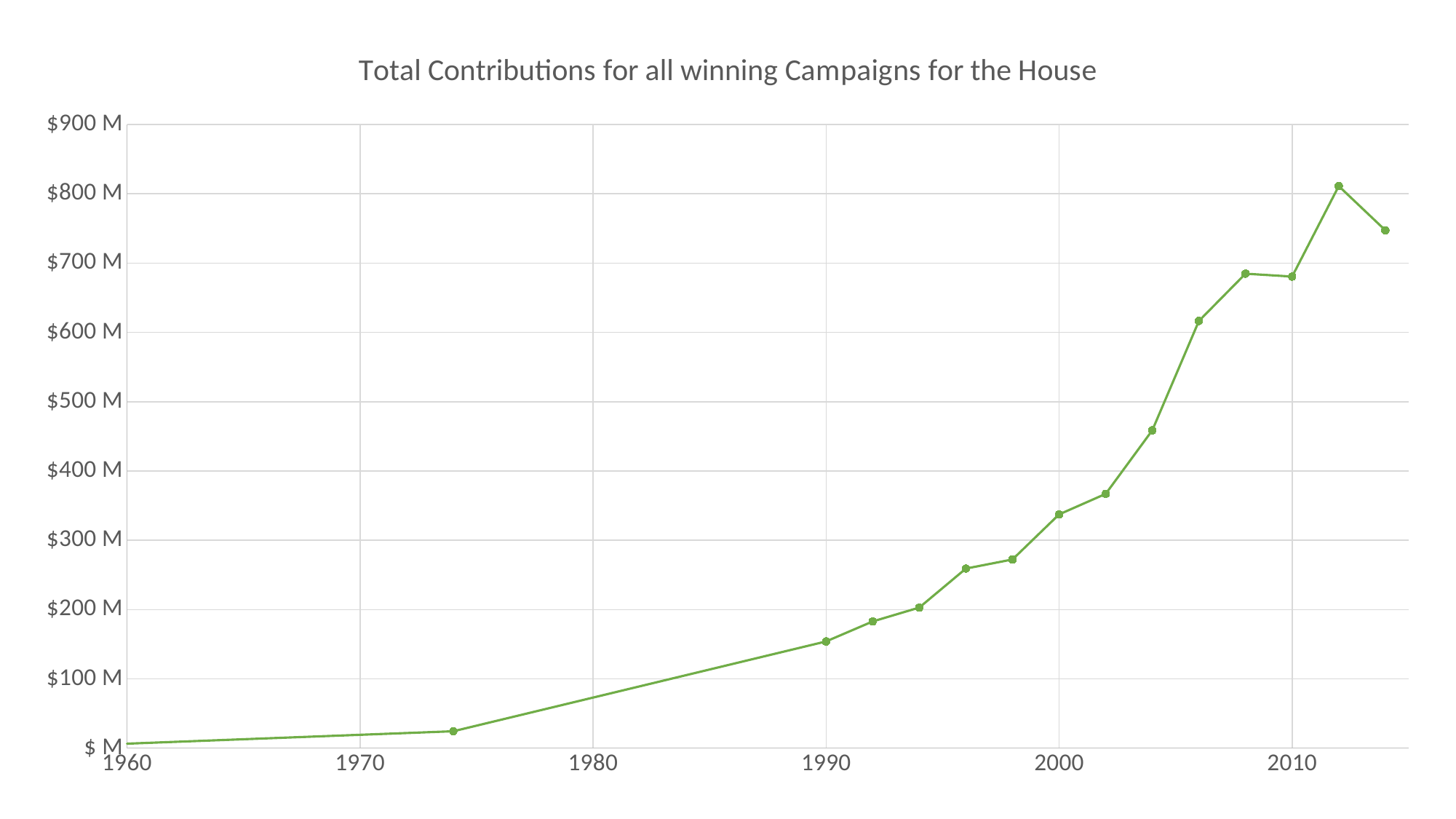
How many data points are plotted on the line? 14 What is the title of the chart? Total Contributions for all winning Campaigns for the House Which year has the larger value, 2012 or 2014? 2012 Is the value for 2004 greater or less than $500 M? less Is the value for 2014 greater or less than $800 M? less Which year has the larger value, 2004 or 2006? 2006 In which year does the line reach its highest value? 2012 Overall, do the values rise or fall from 1960 to 2012? rise Is the value for 1974 greater or less than $100 M? less What kind of chart is shown on the slide? line chart